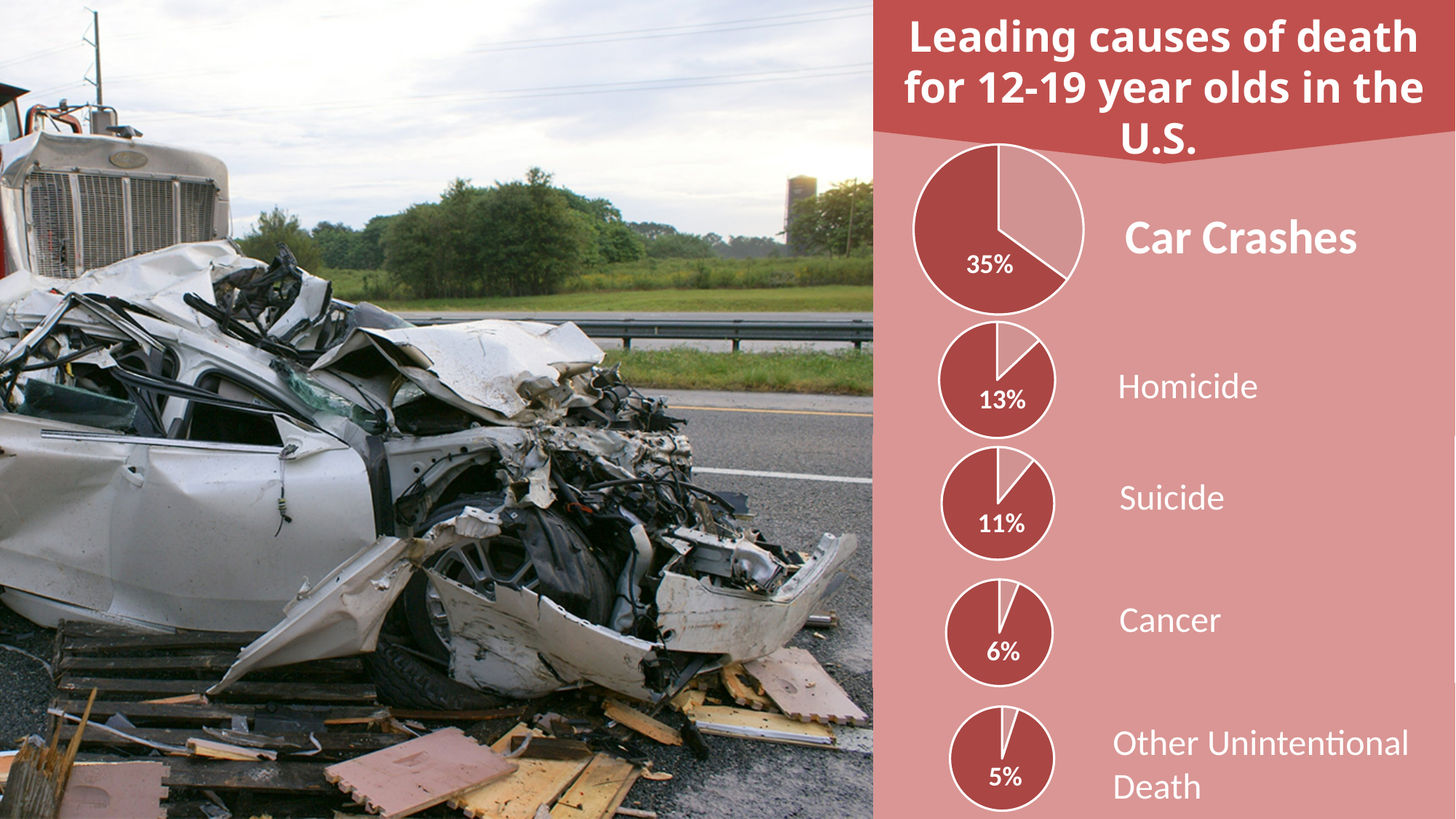
What is the title above the pie charts on the slide? Leading causes of death for 12-19 year olds in the U.S. Which is larger, the percentage in the Suicide pie chart or the percentage in the Cancer pie chart? Suicide What percentage is shown in the Homicide pie chart? 13% What percentage is shown in the Car Crashes pie chart? 35% What is the difference in percentage points between the Car Crashes pie chart and the Homicide pie chart? 22 Which cause of death has the lowest percentage among the pie charts on the slide? Other Unintentional Death How many pie charts are shown on the slide? 5 What percentage is shown in the Other Unintentional Death pie chart? 5% What percentage is shown in the Cancer pie chart? 6% Which cause of death has the highest percentage among the pie charts on the slide? Car Crashes What type of chart is used to show each cause of death on the slide? Pie chart What percentage is shown in the Suicide pie chart? 11%